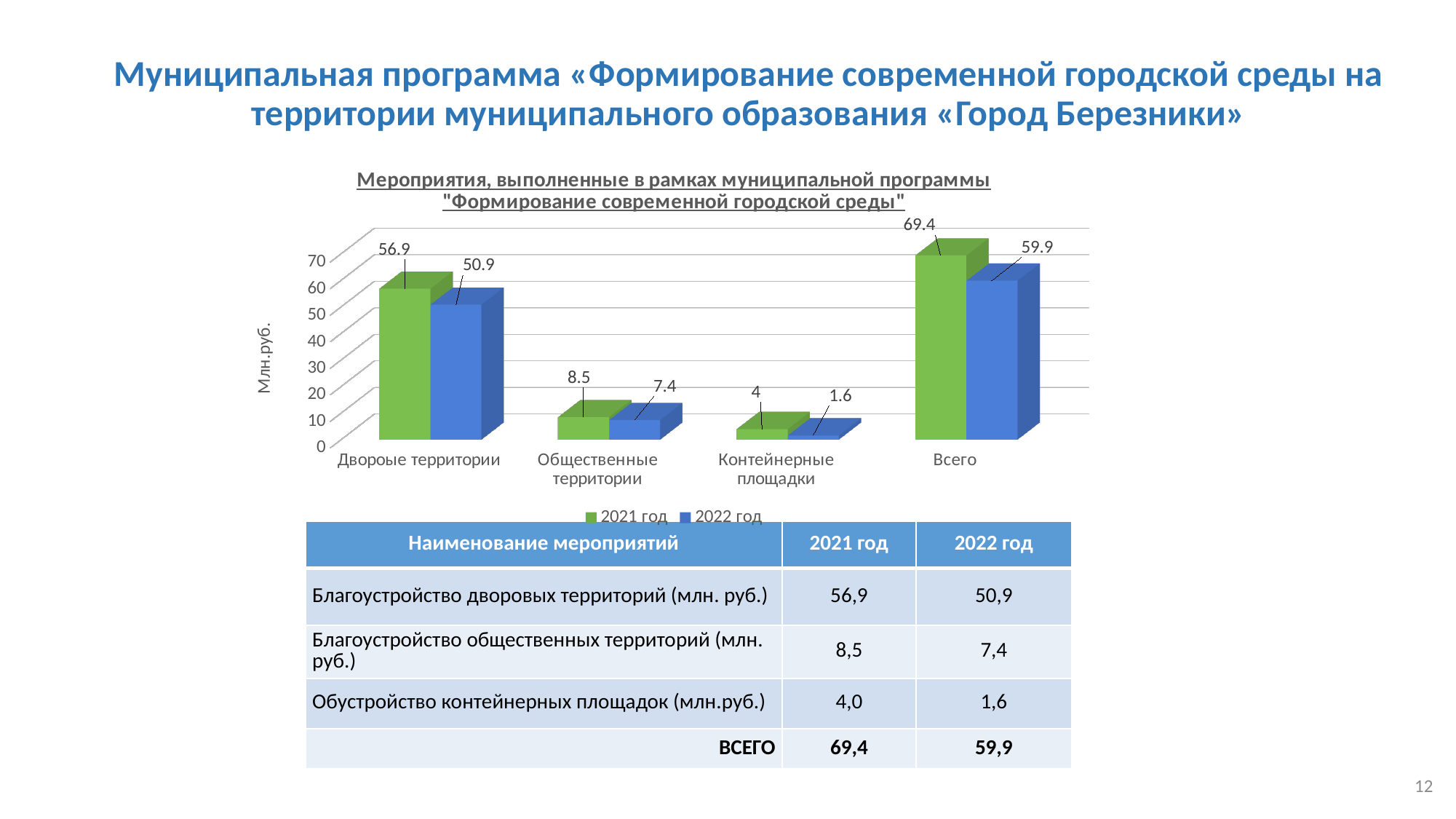
Is the 2022 год value for Двороые территории greater or less than 40? greater What is the difference between the 2021 год and 2022 год values for Всего? 9.5 What is the difference between the 2021 год and 2022 год values for Двороые территории? 6 Which is larger: the 2021 год value for Общественные территории or the 2022 год value for Общественные территории? 2021 год How many series does the legend list? 2 What is the value for Двороые территории in the 2021 год series? 56.9 What is the value for Общественные территории in the 2022 год series? 7.4 What kind of chart is shown on the slide? bar chart Which category has the lowest value in the 2021 год series? Контейнерные площадки Which category has the highest value in the 2022 год series? Всего What is the value for Контейнерные площадки in the 2022 год series? 1.6 How many categories are shown on the x axis? 4